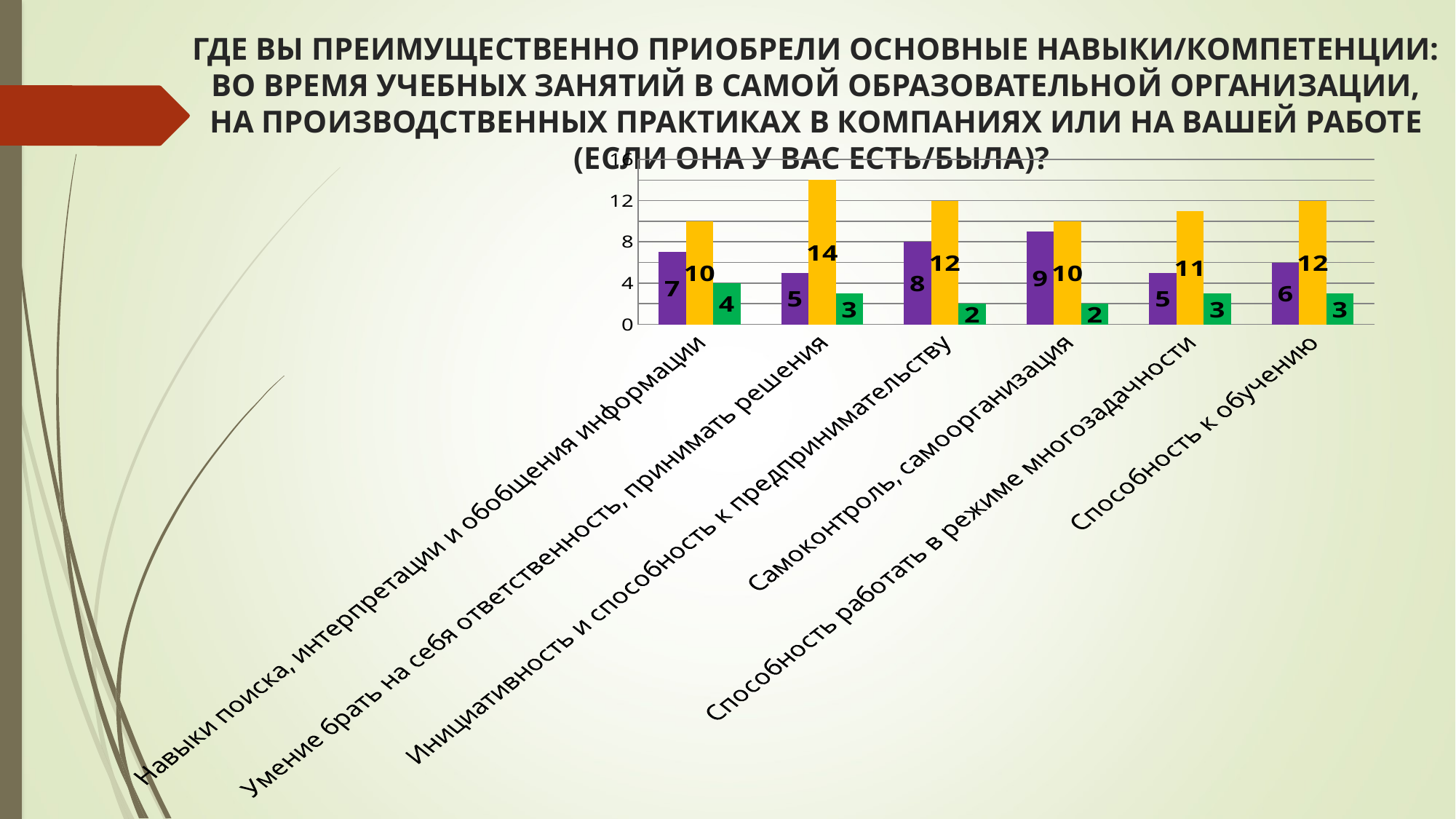
How many categories are shown on the x axis of the chart? 6 Which category has the highest yellow bar? Умение брать на себя ответственность, принимать решения What is the value of the yellow bar for "Способность работать в режиме многозадачности"? 11 Which category has the highest green bar? Навыки поиска, интерпретации и обобщения информации What is the value of the purple bar for "Самоконтроль, самоорганизация"? 9 Which category has the highest purple bar? Самоконтроль, самоорганизация What is the value of the green bar for "Навыки поиска, интерпретации и обобщения информации"? 4 What is the value of the yellow bar for "Умение брать на себя ответственность, принимать решения"? 14 What is the difference between the yellow and purple bars for "Умение брать на себя ответственность, принимать решения"? 9 What type of chart is shown on the slide? bar chart For "Способность к обучению", which is larger: the purple bar or the yellow bar? the yellow bar What is the difference between the purple and green bars for "Инициативность и способность к предпринимательству"? 6